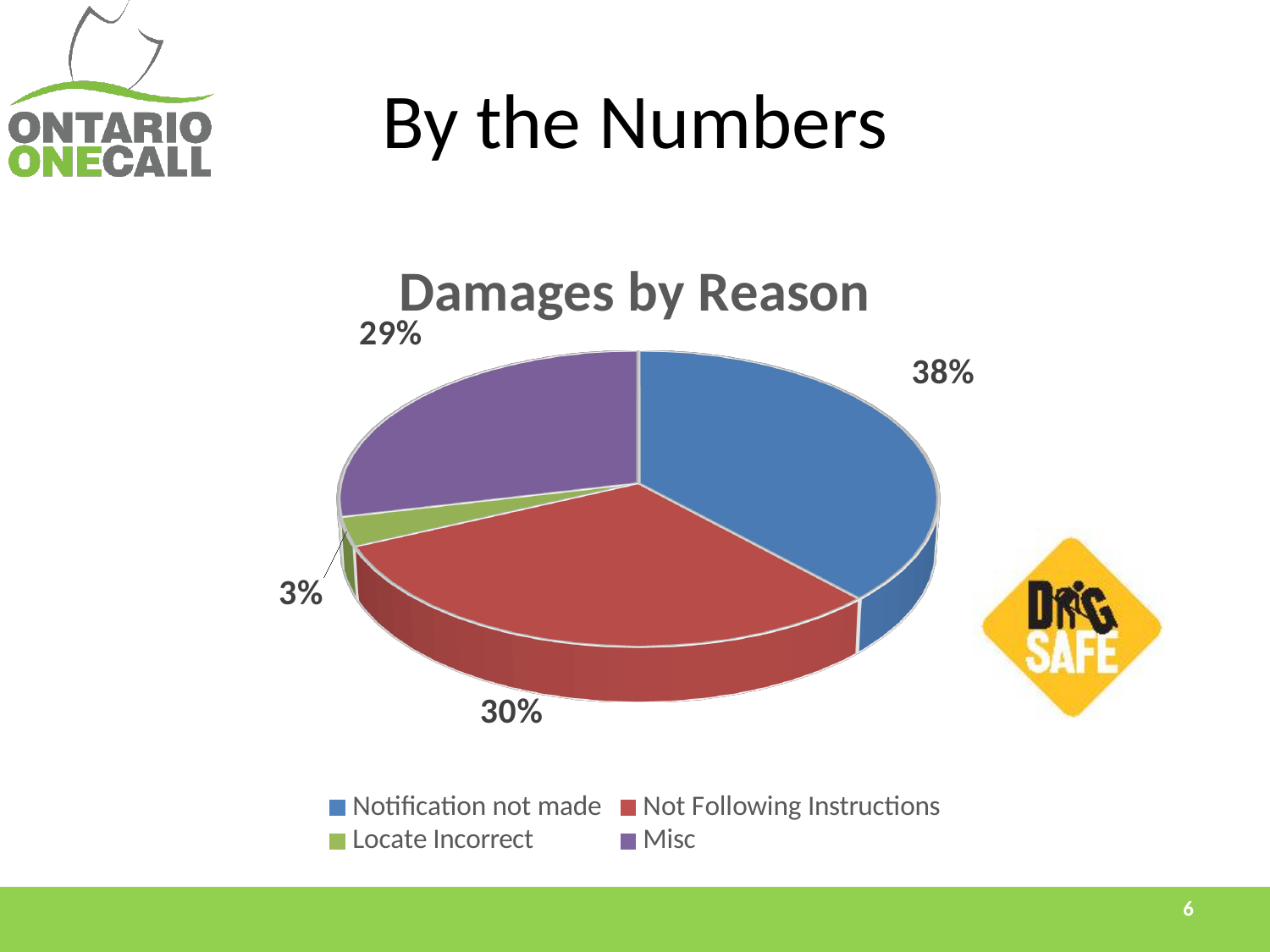
What share of damages is attributed to Misc? 29% Which colour represents Misc in the pie chart? purple What is the title of the chart? Damages by Reason Which is larger, the share for Not Following Instructions or the share for Locate Incorrect? Not Following Instructions What share of damages is attributed to Notification not made? 38% What is the difference in percentage points between Notification not made and Misc? 9 What kind of chart is shown on the slide? pie chart Which reason accounts for the largest share of damages? Notification not made Which reason accounts for the smallest share of damages? Locate Incorrect What share of damages is attributed to Not Following Instructions? 30% How many categories does the pie chart show? 4